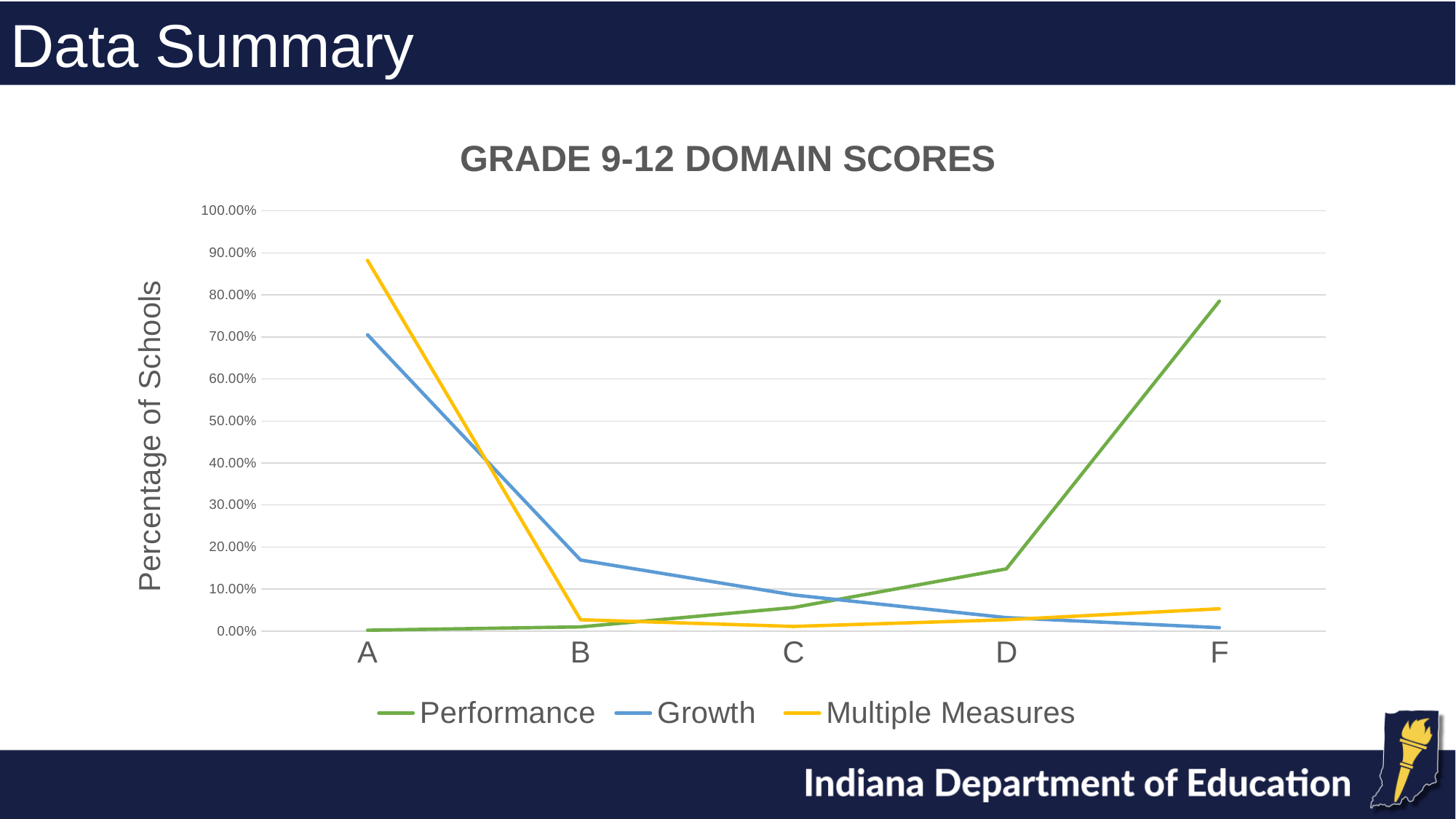
What kind of chart is shown on the slide? Line chart What is the title of the y axis? Percentage of Schools Is the value for Multiple Measures at A greater or less than 80.00%? greater For which category is the Performance series highest? F Does the Performance series rise or fall from A to F? Rise Is the value for Performance at F greater or less than 70.00%? greater For which category is the Multiple Measures series highest? A At category A, which is larger: Multiple Measures or Growth? Multiple Measures How many series does the legend list? 3 How many categories are shown on the x axis of the chart? 5 For which category is the Growth series highest? A Is the value for Growth at B greater or less than 20.00%? less